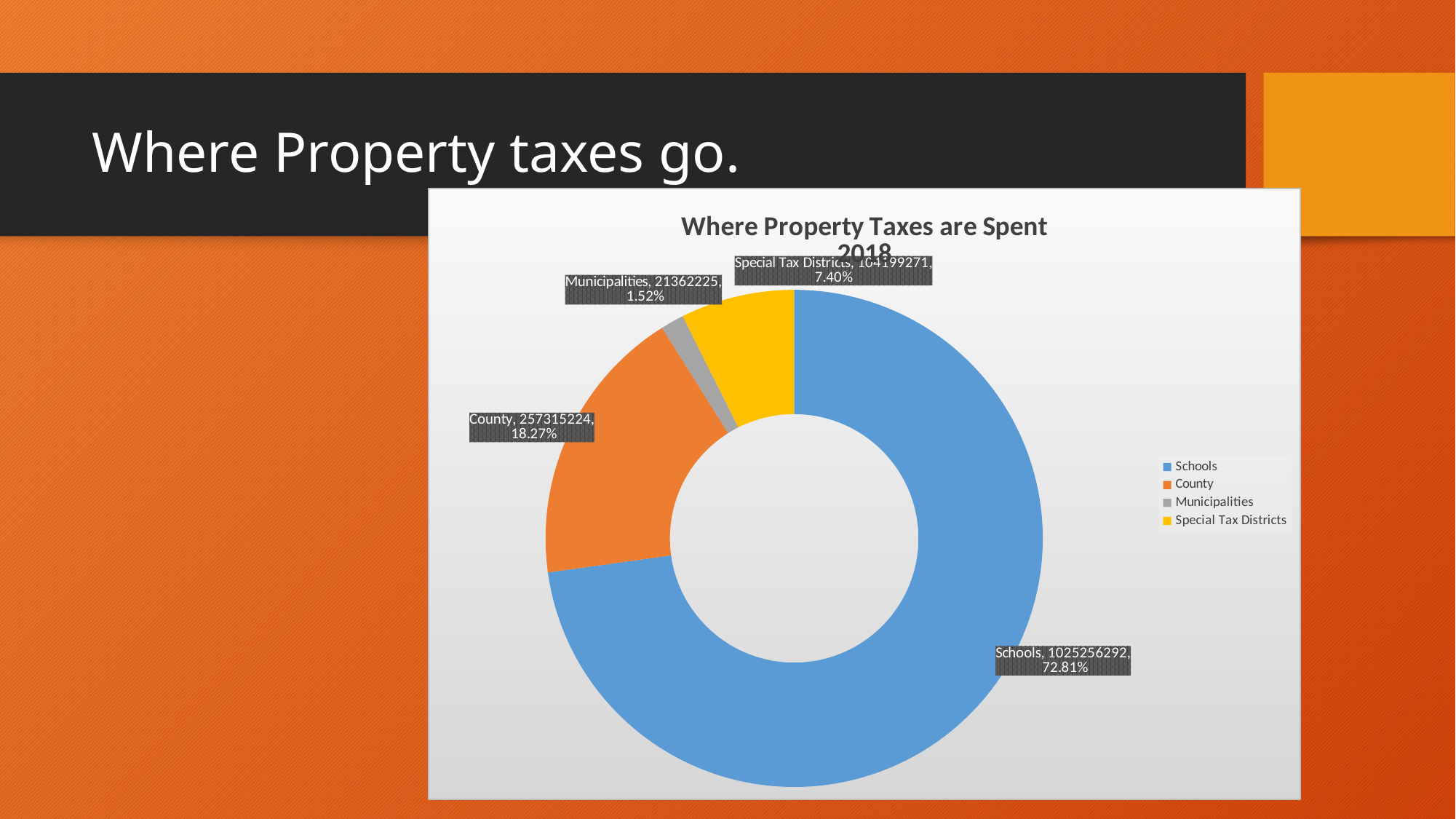
What percentage of property taxes is spent on Schools? 72.81% What is the title of the chart? Where Property Taxes are Spent 2018 What colour represents Special Tax Districts in the chart? yellow What kind of chart is shown on the slide? doughnut chart What is the value shown for County? 257315224 What percentage share does Special Tax Districts have? 7.40% How many categories are shown in the chart? 4 Which category receives the smallest share of property taxes? Municipalities Which is larger, the share for County or the share for Special Tax Districts? County What is the difference in percentage points between the Schools share and the County share? 54.54% What is the value shown for Municipalities? 21362225 Which category receives the largest share of property taxes? Schools